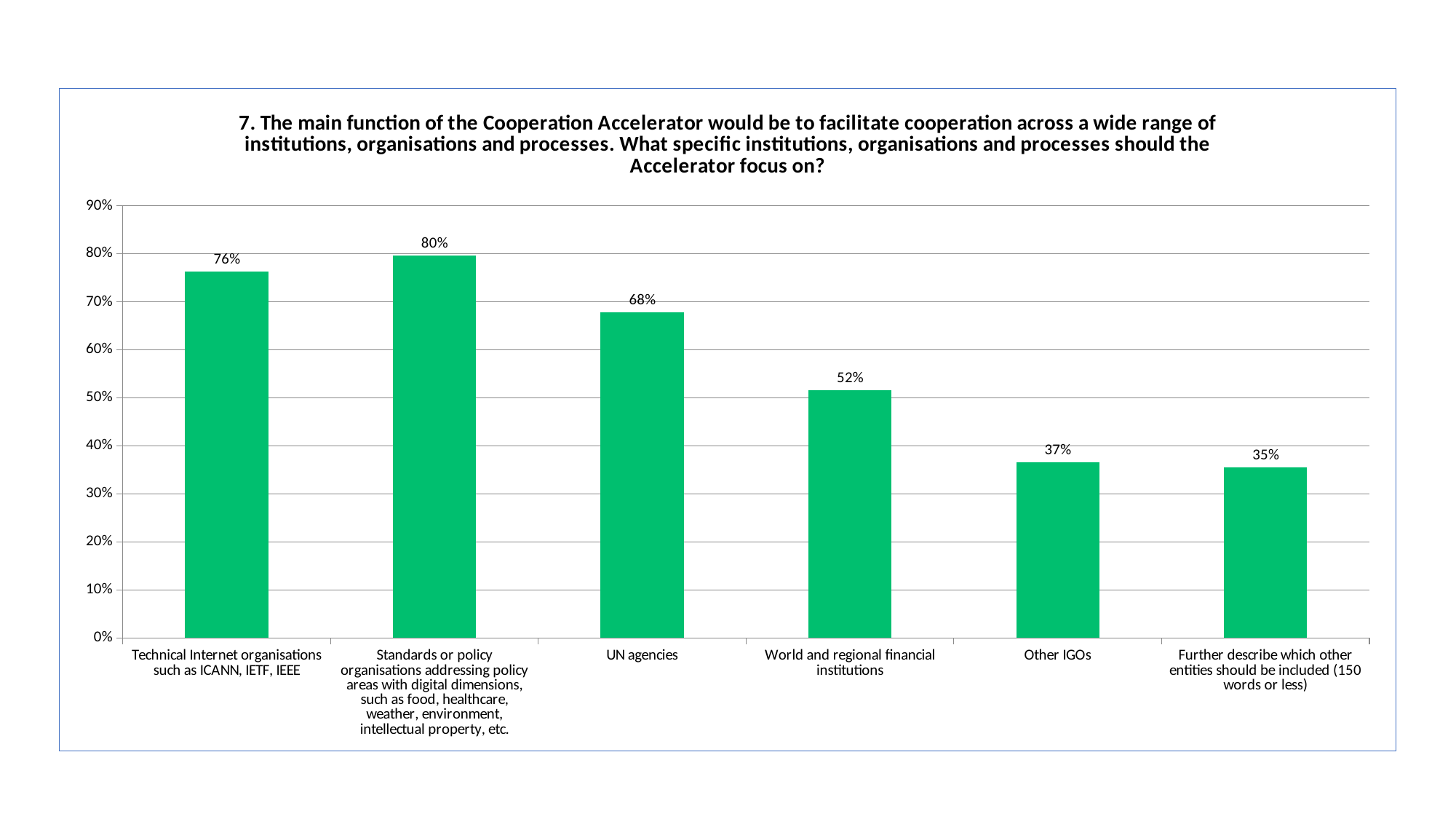
What is the value for Technical Internet organisations such as ICANN, IETF, IEEE? 76% Which is larger: the value for Technical Internet organisations such as ICANN, IETF, IEEE or the value for UN agencies? Technical Internet organisations such as ICANN, IETF, IEEE What kind of chart is shown on the slide? bar chart Is the value for World and regional financial institutions greater or less than 60%? less Which category has the highest value? Standards or policy organisations addressing policy areas with digital dimensions, such as food, healthcare, weather, environment, intellectual property, etc. What is the value for Other IGOs? 37% What is the difference between the values for UN agencies and World and regional financial institutions? 16% What is the value for World and regional financial institutions? 52% What colour are the bars in the chart? green Which category has the lowest value? Further describe which other entities should be included (150 words or less) What is the value for UN agencies? 68% How many categories are shown on the x axis? 6